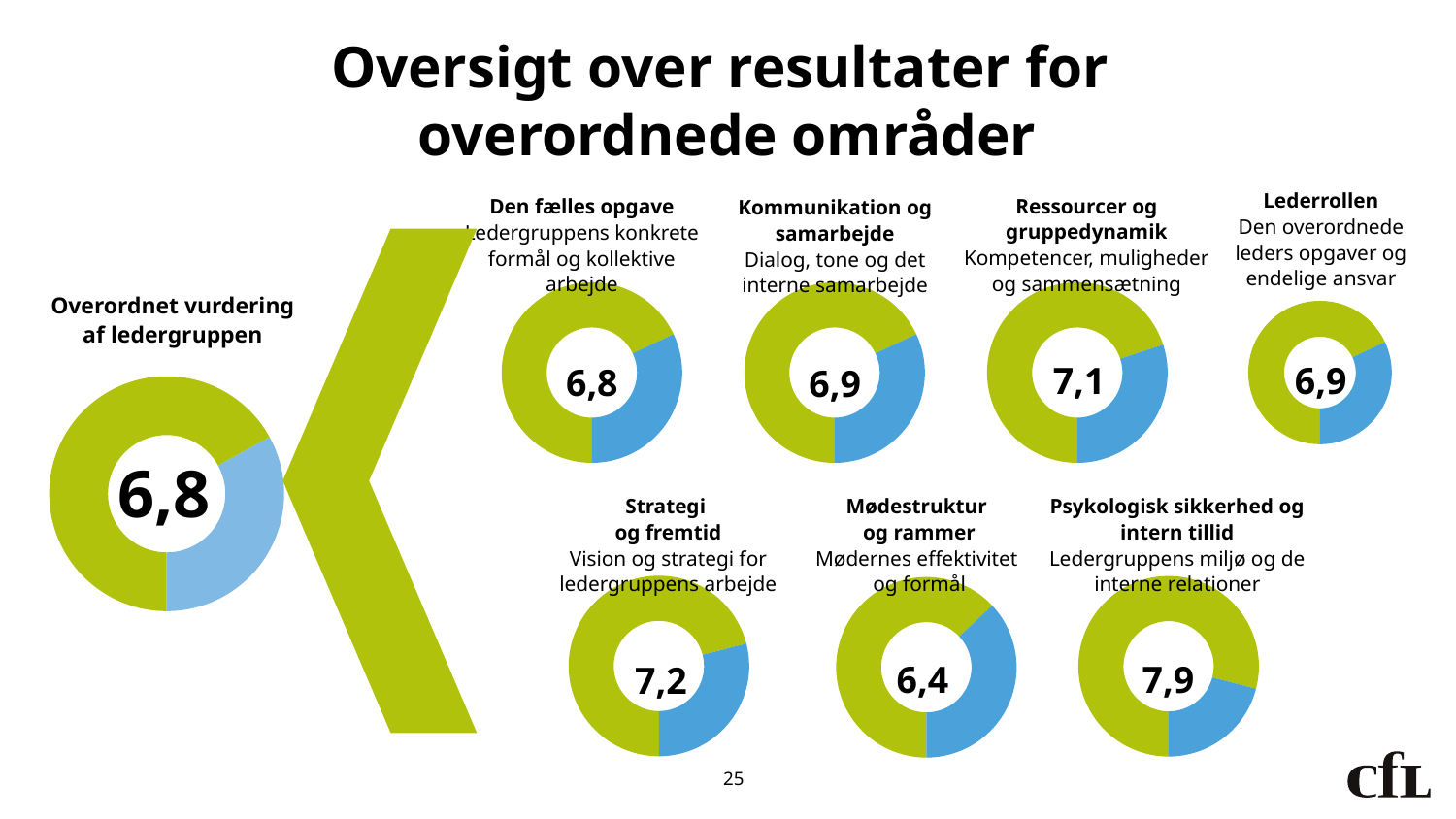
What value is shown for 'Psykologisk sikkerhed og intern tillid'? 7,9 What value is shown for 'Mødestruktur og rammer'? 6,4 How many donut charts are shown on the slide? 8 What value is shown for 'Ressourcer og gruppedynamik'? 7,1 Which has the larger value, 'Strategi og fremtid' or 'Ressourcer og gruppedynamik'? Strategi og fremtid Which area has the lowest value among the donut charts on the slide? Mødestruktur og rammer What value is shown for 'Den fælles opgave'? 6,8 What value is shown for 'Kommunikation og samarbejde'? 6,9 Which area has the highest value among the donut charts on the slide? Psykologisk sikkerhed og intern tillid What value is shown for 'Lederrollen'? 6,9 What is the difference between the value for 'Psykologisk sikkerhed og intern tillid' and the value for 'Mødestruktur og rammer'? 1,5 What value is shown in the centre of the 'Overordnet vurdering af ledergruppen' donut chart? 6,8